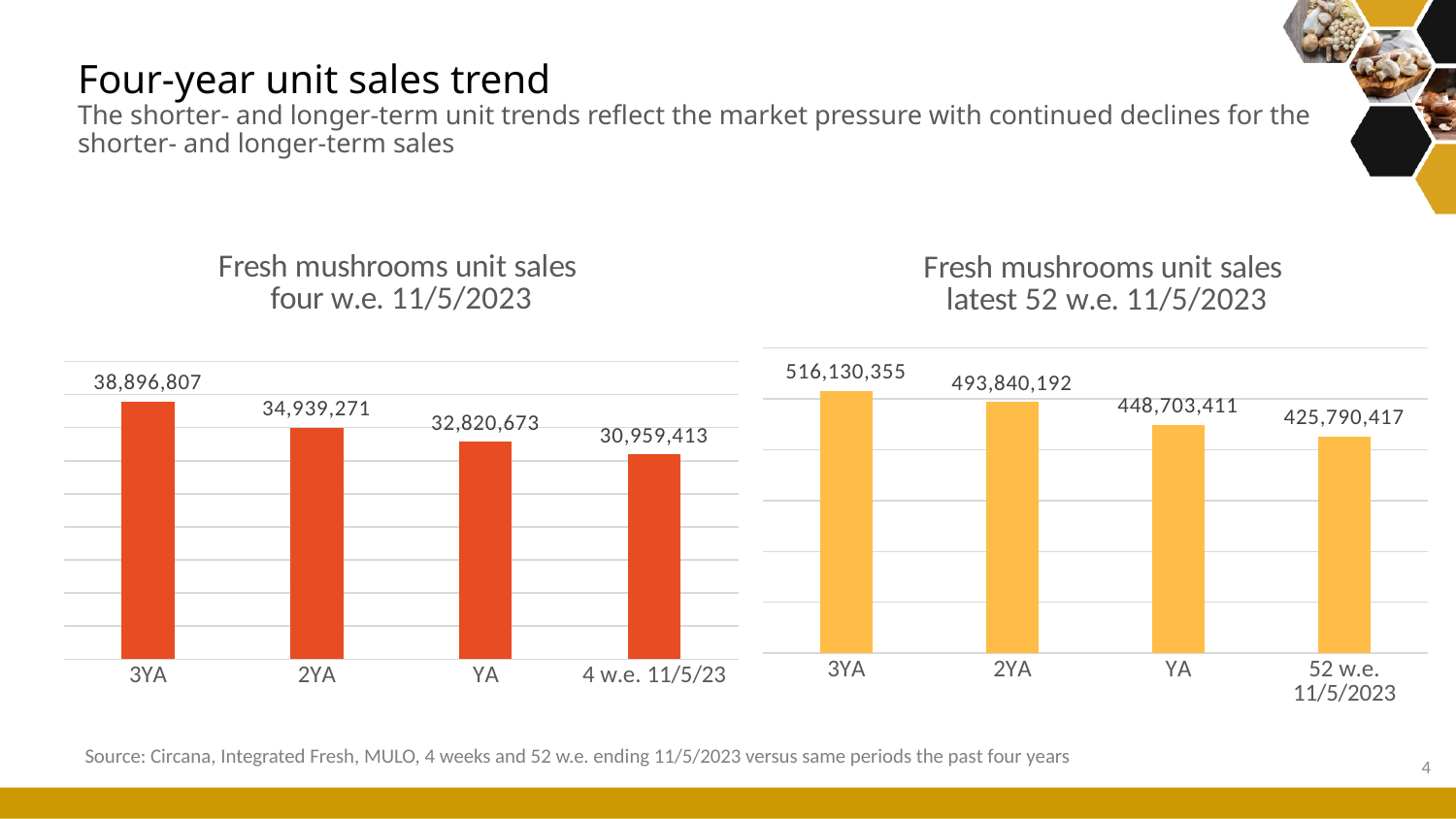
How many bars are in the 'Fresh mushrooms unit sales latest 52 w.e. 11/5/2023' chart? 4 In the 'Fresh mushrooms unit sales four w.e. 11/5/2023' chart, what is the value for 3YA? 38,896,807 In the 'Fresh mushrooms unit sales four w.e. 11/5/2023' chart, which category has the highest value? 3YA In the 'Fresh mushrooms unit sales latest 52 w.e. 11/5/2023' chart, do the values rise or fall from 3YA to 52 w.e. 11/5/2023? Fall In the 'Fresh mushrooms unit sales four w.e. 11/5/2023' chart, which is larger, the value for 2YA or the value for YA? 2YA In the 'Fresh mushrooms unit sales four w.e. 11/5/2023' chart, what is the difference between the 3YA value and the 4 w.e. 11/5/23 value? 7,937,394 In the 'Fresh mushrooms unit sales latest 52 w.e. 11/5/2023' chart, what is the value for YA? 448,703,411 What type of chart is the 'Fresh mushrooms unit sales four w.e. 11/5/2023' chart? Bar chart In the 'Fresh mushrooms unit sales latest 52 w.e. 11/5/2023' chart, what is the value for 52 w.e. 11/5/2023? 425,790,417 In the 'Fresh mushrooms unit sales latest 52 w.e. 11/5/2023' chart, which category has the lowest value? 52 w.e. 11/5/2023 In the 'Fresh mushrooms unit sales four w.e. 11/5/2023' chart, what is the value for 4 w.e. 11/5/23? 30,959,413 In the 'Fresh mushrooms unit sales latest 52 w.e. 11/5/2023' chart, what is the difference between the 3YA value and the 2YA value? 22,290,163